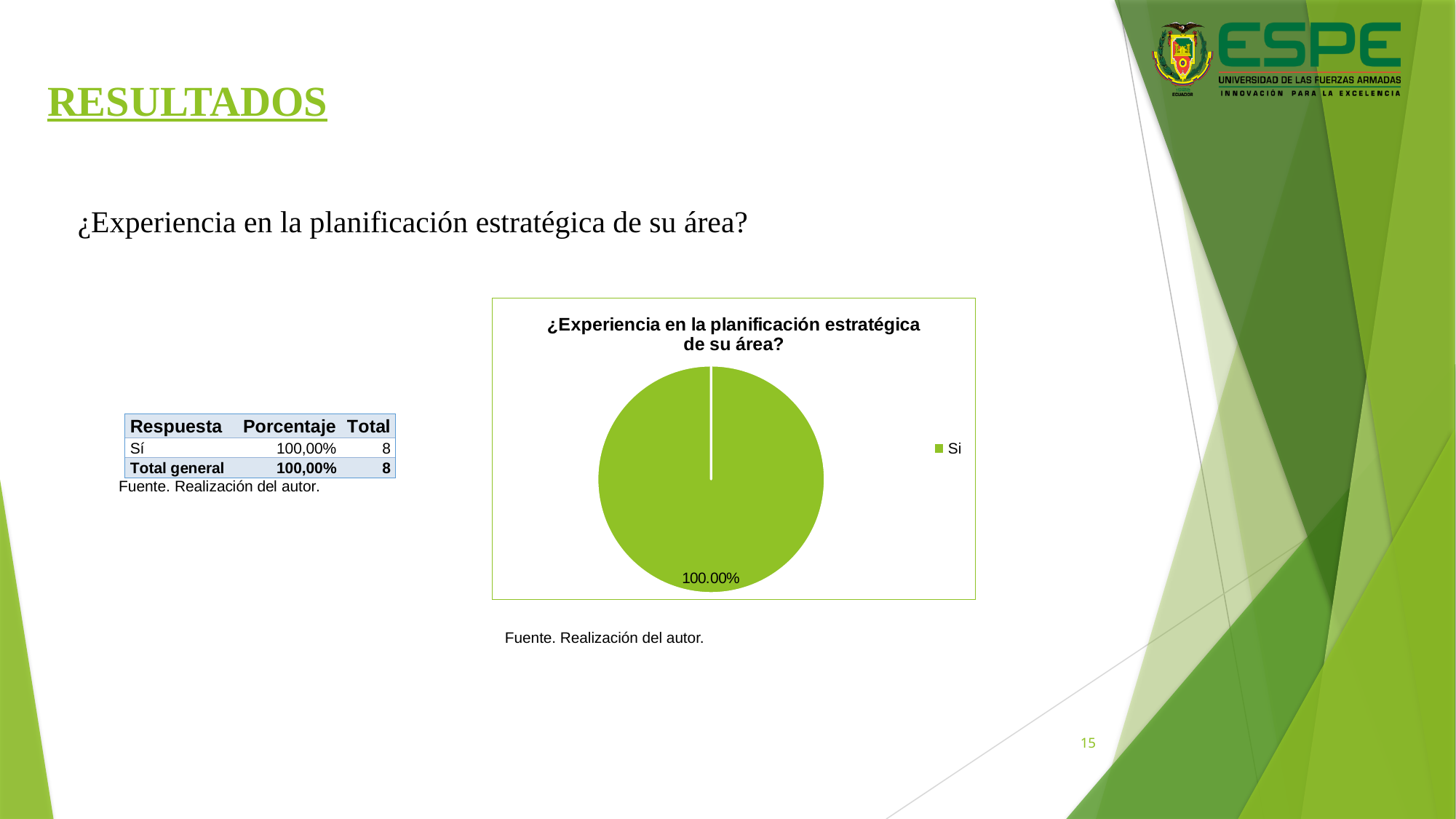
How many slices does the pie chart have? 1 What is the title of the chart? ¿Experiencia en la planificación estratégica de su área? How many entries does the chart legend list? 1 What percentage is shown on the data label of the pie slice? 100.00% What share of the pie does the 'Si' slice represent? 100.00% What is the legend entry for the pie slice? Si What kind of chart is shown on the slide? pie chart Is the value for 'Si' greater or less than 50%? greater